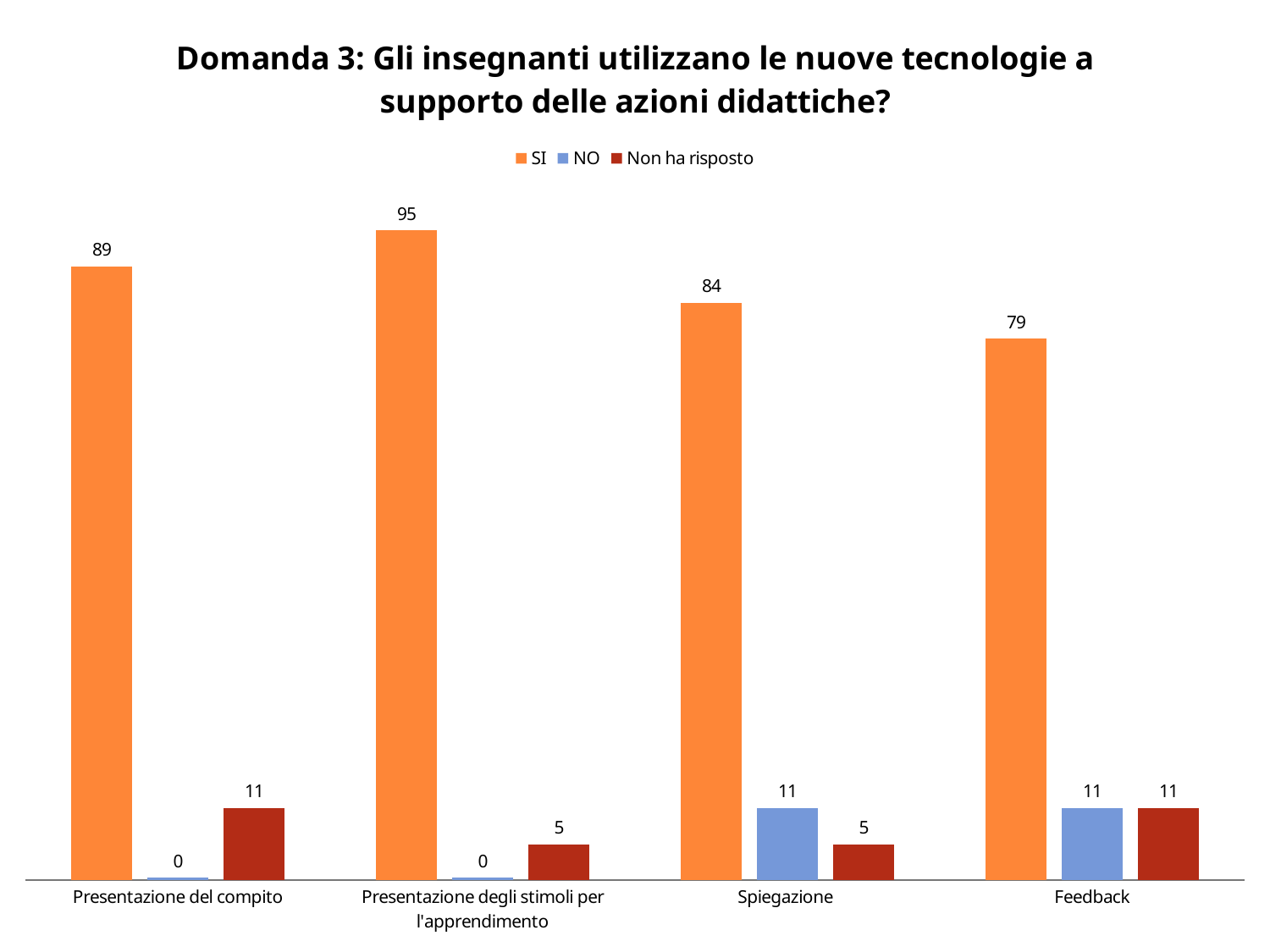
What is the SI value for Presentazione del compito? 89 Which category has the highest SI value? Presentazione degli stimoli per l'apprendimento How many series does the legend list? 3 Which is larger, the SI value for Spiegazione or the SI value for Presentazione del compito? Presentazione del compito What is the Non ha risposto value for Presentazione degli stimoli per l'apprendimento? 5 Which series is shown in orange? SI Which category has the lowest SI value? Feedback What is the difference between the SI values for Presentazione degli stimoli per l'apprendimento and Feedback? 16 What is the NO value for Presentazione del compito? 0 What kind of chart is shown on the slide? Bar chart What is the NO value for Spiegazione? 11 How many categories are shown on the x axis? 4